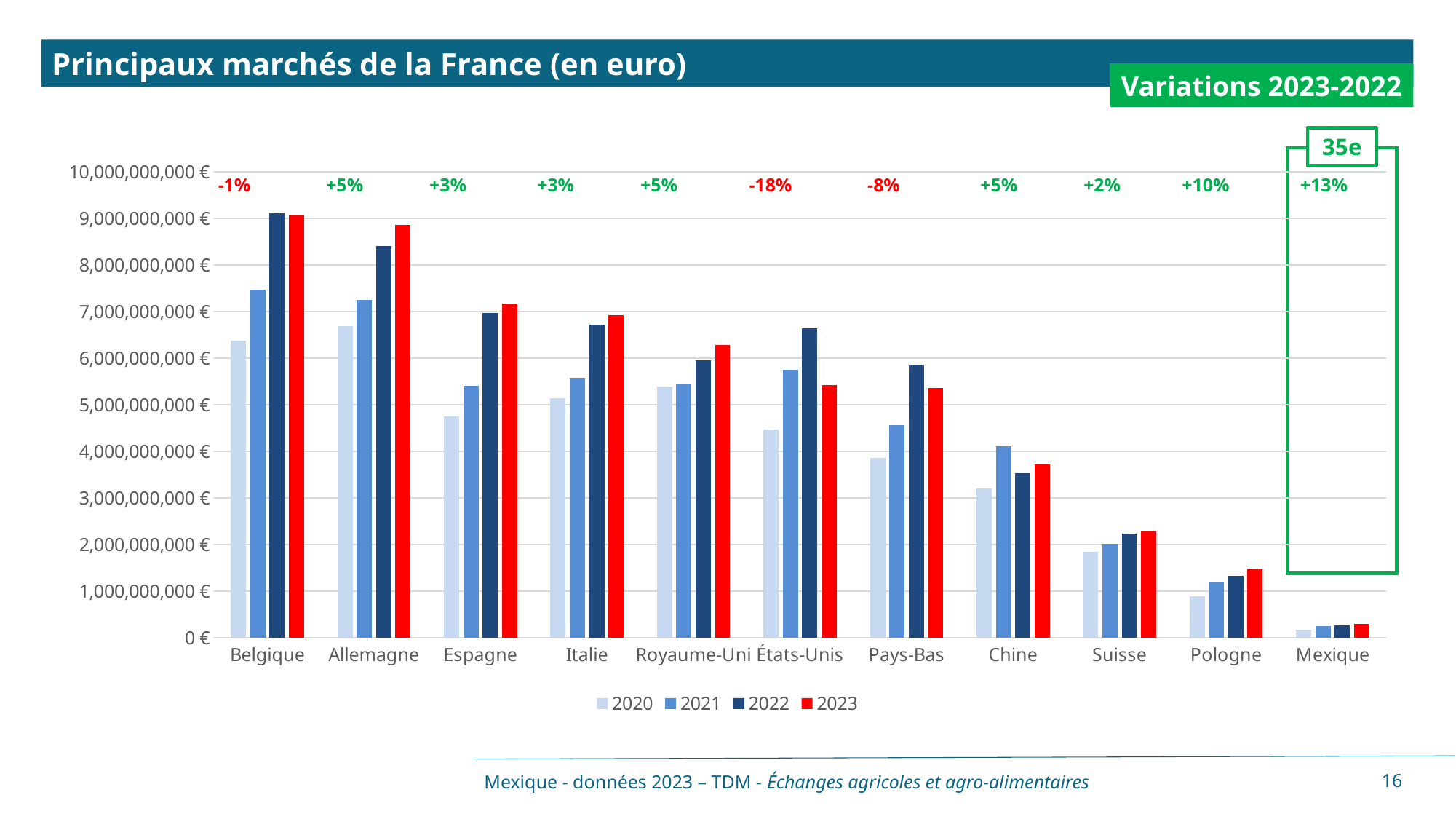
Is the 2023 value for Chine greater or less than 4,000,000,000 €? less What kind of chart is shown on the slide? bar chart What is the 2023-2022 variation printed above États-Unis? -18% Which country has the lowest 2023 value? Mexique How many series does the legend list? 4 What is the 2023-2022 variation printed above Belgique? -1% How many countries are shown on the x axis of the chart? 11 Is the 2023 value for Belgique greater or less than 8,000,000,000 €? greater Which country has the highest 2023-2022 variation printed on the chart? Mexique What is the 2023-2022 variation printed above Pologne? +10% Which country has the highest 2023 value? Belgique For États-Unis, which is larger: the 2022 value or the 2023 value? 2022